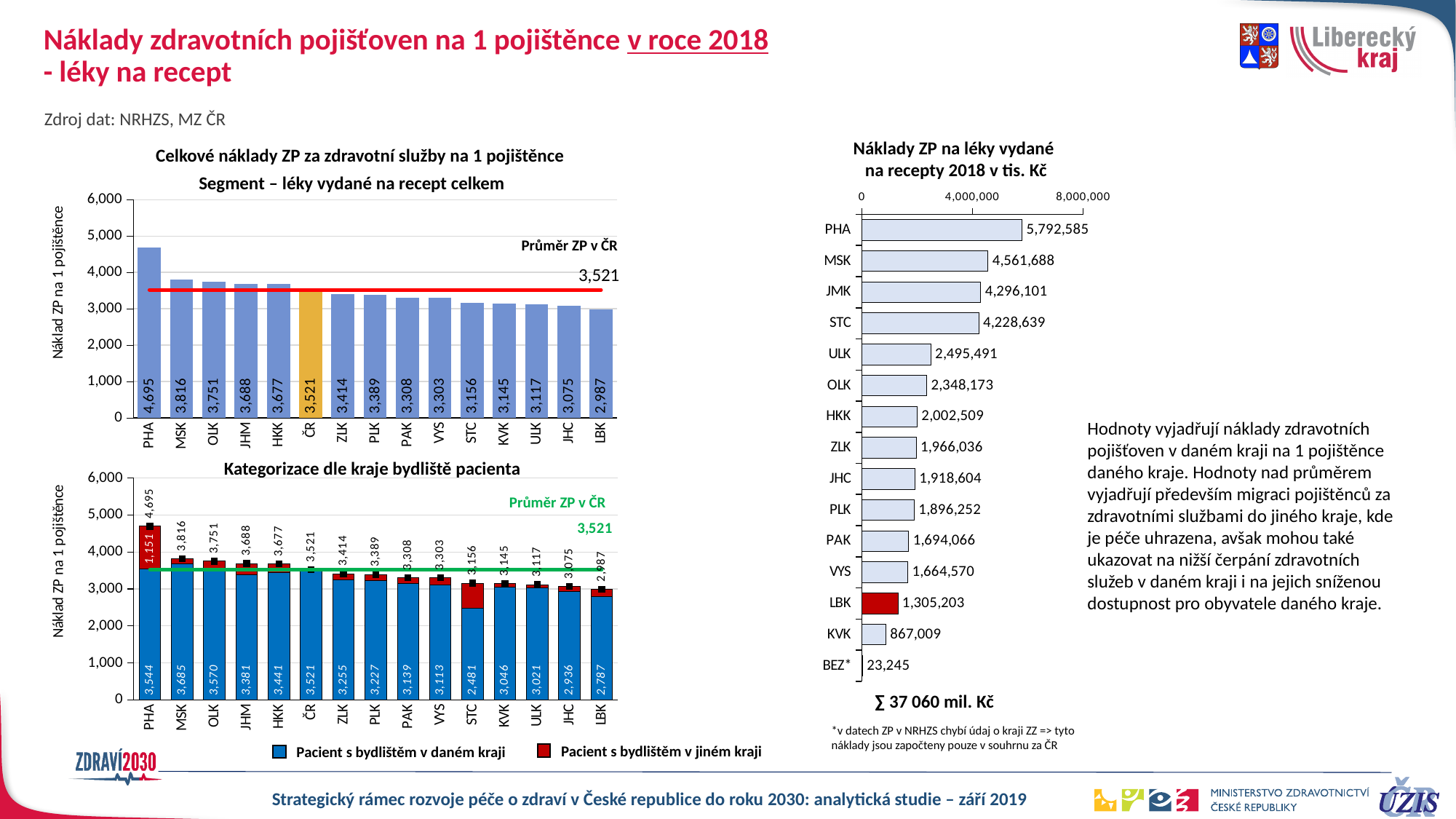
In the right chart 'Náklady ZP na léky vydané na recepty 2018 v tis. Kč', which is larger, the value for ULK or for OLK? ULK In the right chart 'Náklady ZP na léky vydané na recepty 2018 v tis. Kč', what is the value for LBK? 1,305,203 In the top-left chart 'Celkové náklady ZP za zdravotní služby na 1 pojištěnce', what is the value for LBK? 2,987 In the top-left chart 'Celkové náklady ZP za zdravotní služby na 1 pojištěnce', which category has the highest value? PHA What kind of chart is the right chart 'Náklady ZP na léky vydané na recepty 2018 v tis. Kč'? bar chart In the bottom-left chart 'Kategorizace dle kraje bydliště pacienta', what is the value of 'Pacient s bydlištěm v jiném kraji' for PHA? 1,151 In the top-left chart 'Celkové náklady ZP za zdravotní služby na 1 pojištěnce', do the bar values rise or fall from left to right? fall In the top-left chart 'Celkové náklady ZP za zdravotní služby na 1 pojištěnce', what is the difference between the values for PHA and LBK? 1,708 How many series does the legend of the bottom-left chart 'Kategorizace dle kraje bydliště pacienta' list? 2 In the right chart 'Náklady ZP na léky vydané na recepty 2018 v tis. Kč', which category has the lowest value? BEZ* How many categories are shown on the x axis of the top-left chart 'Celkové náklady ZP za zdravotní služby na 1 pojištěnce'? 15 In the bottom-left chart 'Kategorizace dle kraje bydliště pacienta', what is the value of 'Pacient s bydlištěm v daném kraji' for STC? 2,481